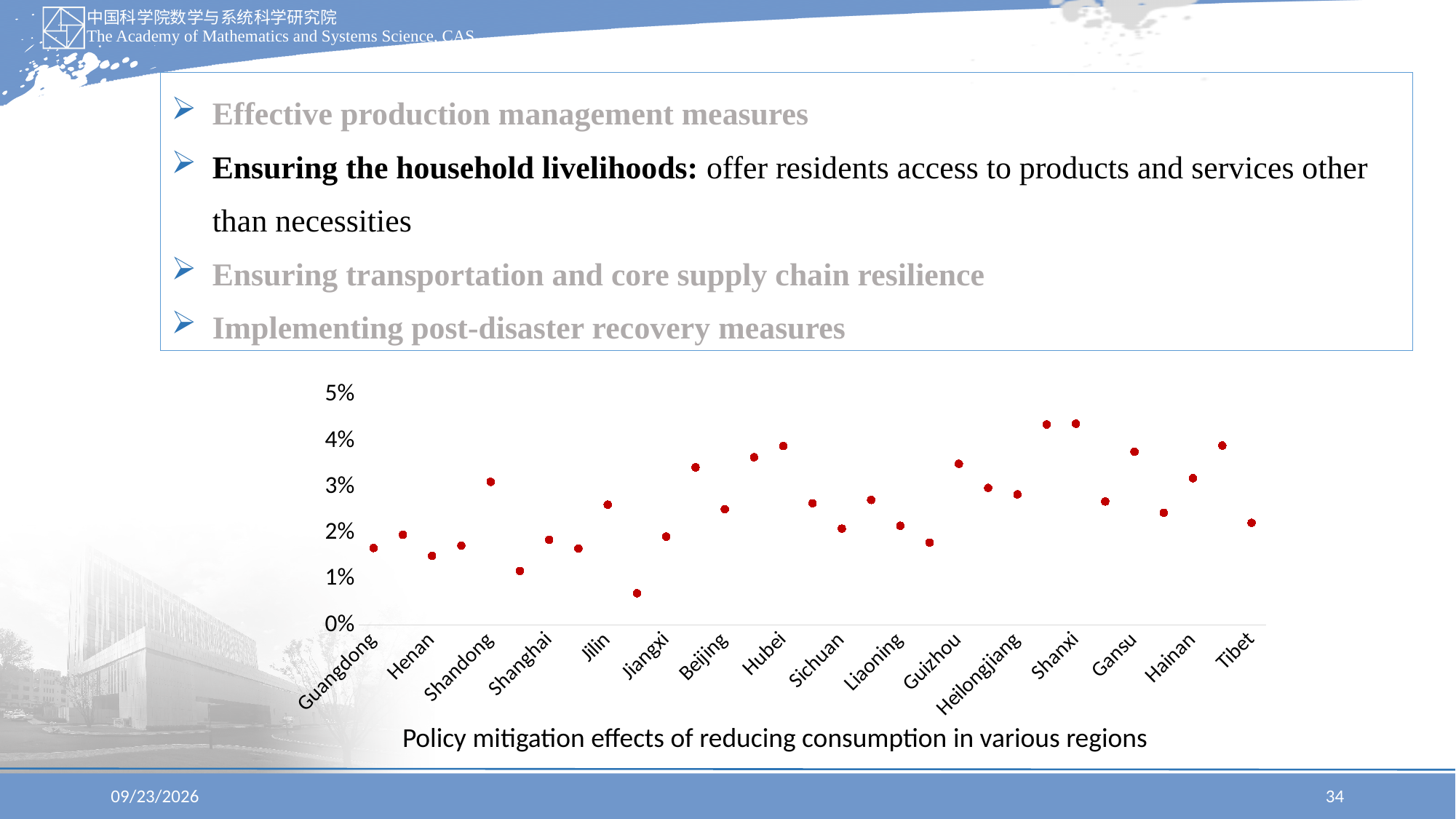
What colour are the data points in the chart? red Which has the larger value, Gansu or Tibet? Gansu How many region labels are shown on the x axis of the chart? 16 Is the value for Henan greater or less than 2%? less Is the value for Shanxi greater or less than 4%? greater Is the value for Tibet greater or less than 3%? less Which has the larger value, Shanxi or Guangdong? Shanxi What kind of chart is shown on the slide? scatter chart What is the title shown below the chart? Policy mitigation effects of reducing consumption in various regions